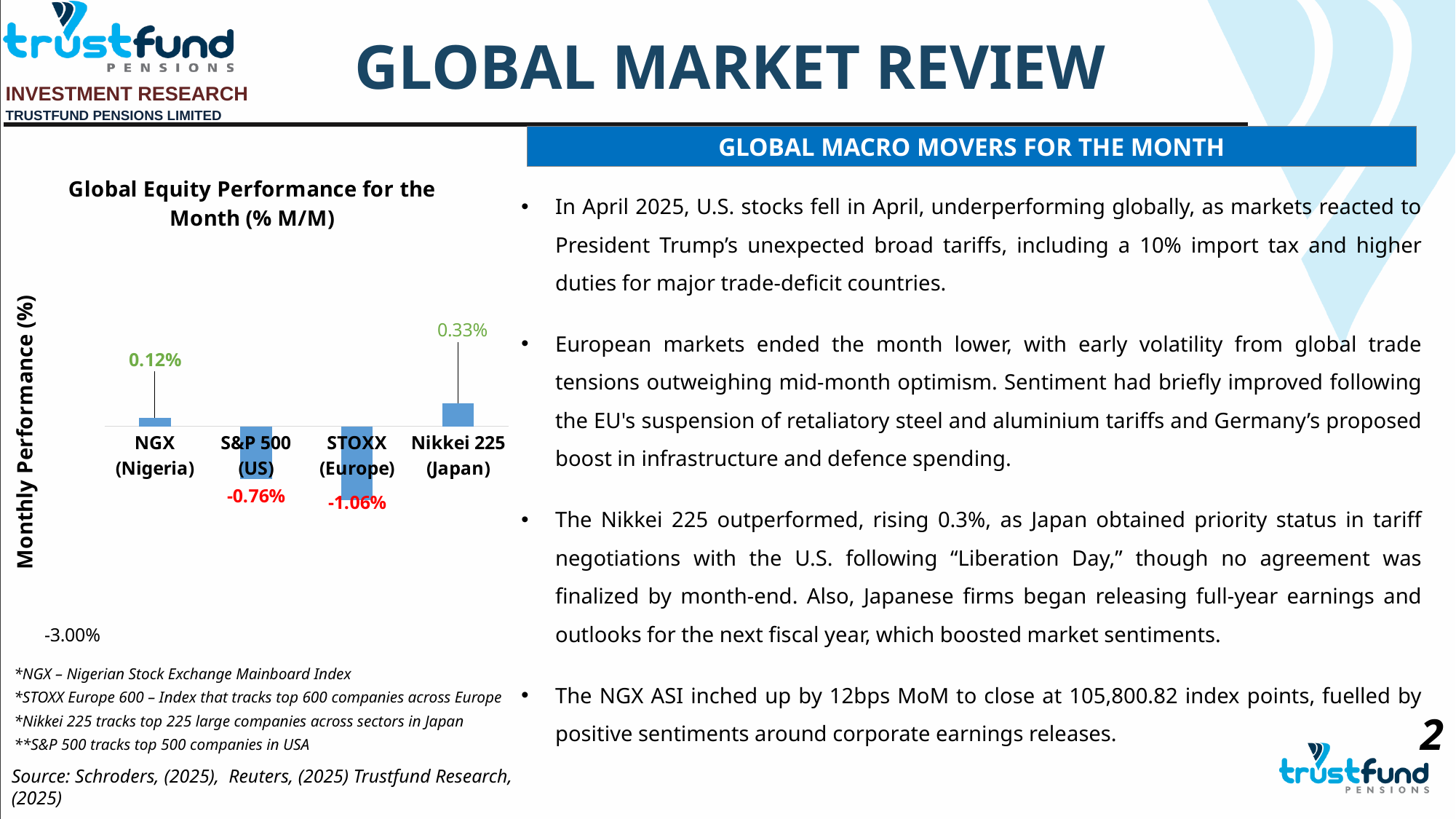
What is the title of the chart on the slide? Global Equity Performance for the Month (% M/M) What is the monthly performance value for NGX (Nigeria)? 0.12% What is the monthly performance value for STOXX (Europe)? -1.06% Which index has the lowest monthly performance in the chart? STOXX (Europe) Which has the larger monthly performance, NGX (Nigeria) or S&P 500 (US)? NGX (Nigeria) Which index has the highest monthly performance in the chart? Nikkei 225 (Japan) How many indices are shown in the chart? 4 What type of chart is used to show Global Equity Performance for the Month? Bar chart What is the monthly performance value for S&P 500 (US)? -0.76% What is the difference between the monthly performance of Nikkei 225 (Japan) and NGX (Nigeria)? 0.21% What is the monthly performance value for Nikkei 225 (Japan)? 0.33% What is the difference between the monthly performance of S&P 500 (US) and STOXX (Europe)? 0.30%